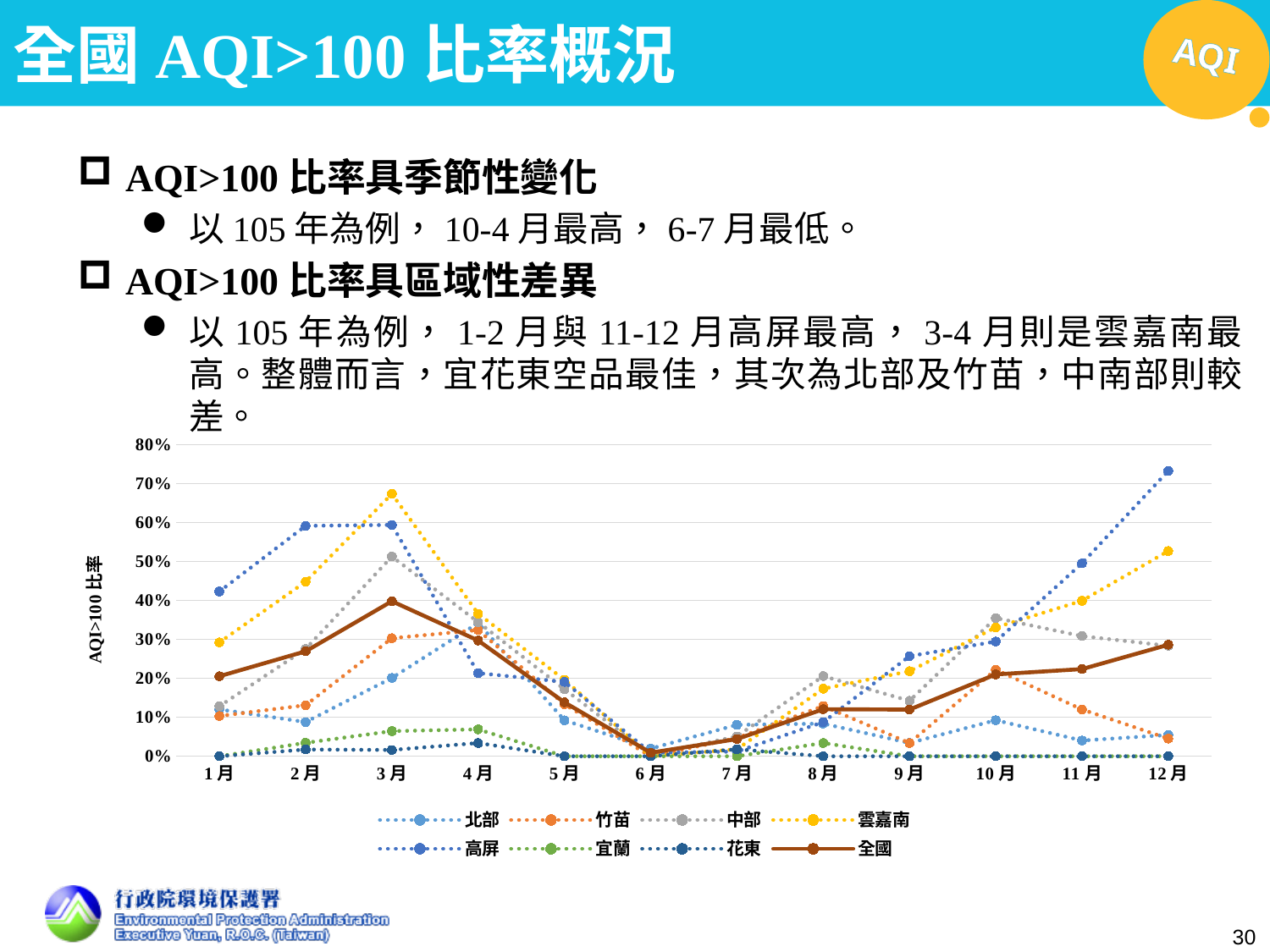
Which series is drawn as a solid line rather than a dotted line? 全國 In 12月, which series has the larger value, 高屏 or 雲嘉南? 高屏 How many series does the chart's legend list? 8 Is the value for 高屏 in 12月 greater or less than 70%? greater Does the 全國 series rise or fall from 3月 to 6月? fall In 3月, which series has the larger value, 雲嘉南 or 高屏? 雲嘉南 Is the value for 雲嘉南 in 3月 greater or less than 60%? greater Is the value for 全國 in 3月 greater or less than 30%? greater In which month does the 全國 series reach its lowest value? 6月 In which month does the 全國 series reach its highest value? 3月 How many months are plotted along the x axis of the chart? 12 What kind of chart is shown on the slide? line chart